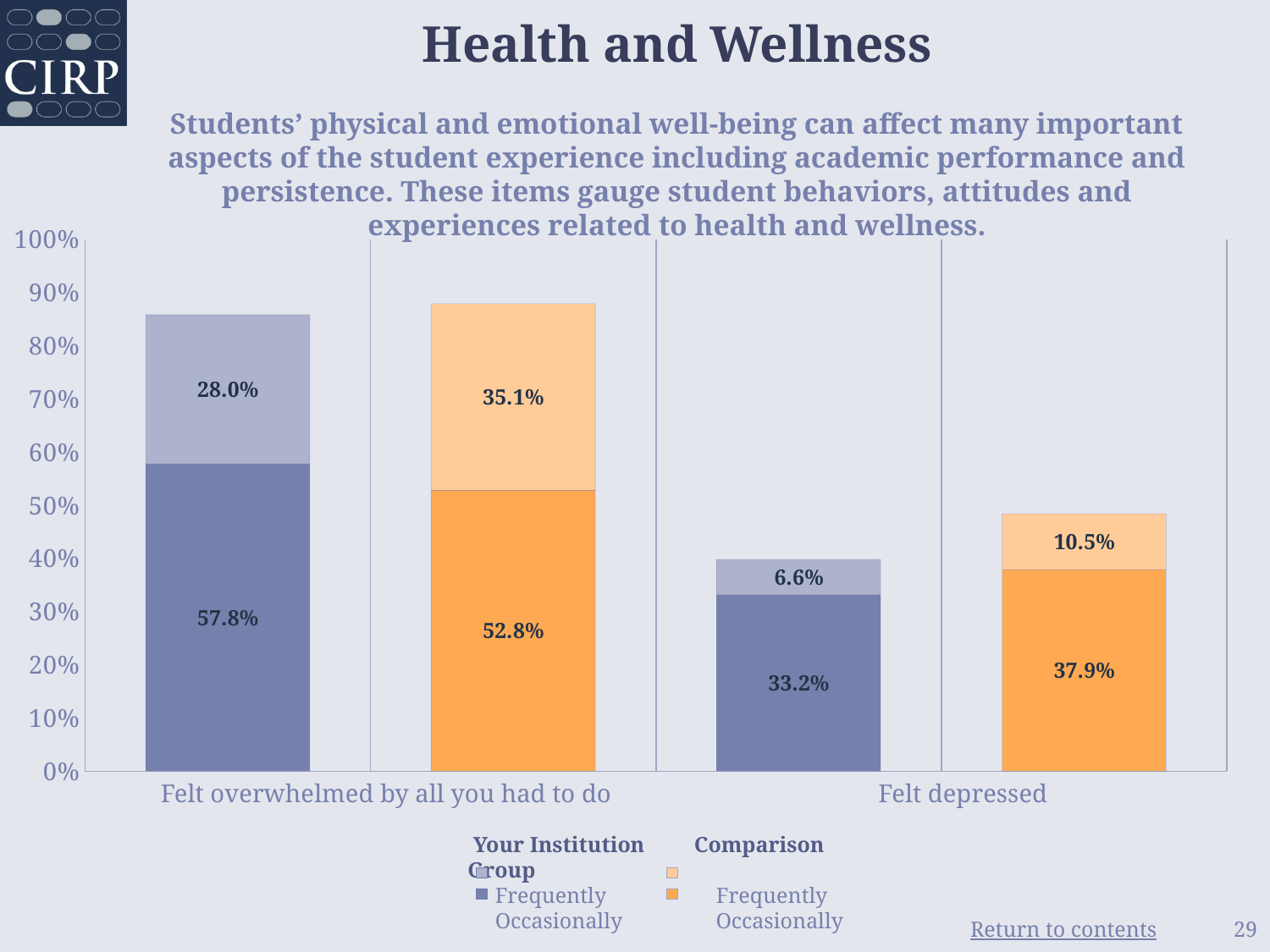
What percentage of students at Your Institution reported frequently feeling overwhelmed by all they had to do? 28.0% What percentage of the Comparison Group reported frequently feeling overwhelmed by all they had to do? 35.1% What percentage of students at Your Institution reported occasionally feeling depressed? 33.2% What is the title of the slide containing the chart? Health and Wellness How many survey items (categories) are shown on the x axis of the chart? 2 What percentage of the Comparison Group reported occasionally feeling depressed? 37.9% What type of chart is shown on the slide? Stacked bar chart What is the combined percentage (frequently plus occasionally) of the Comparison Group who felt depressed? 48.4% What is the difference between the Comparison Group and Your Institution in the percentage who frequently felt depressed? 3.9% What is the combined percentage (frequently plus occasionally) of Your Institution students who felt overwhelmed by all they had to do? 85.8% For 'Felt overwhelmed by all you had to do', which group has the higher percentage reporting 'Frequently': Your Institution or the Comparison Group? Comparison Group Is the total stacked bar for Your Institution under 'Felt depressed' greater or less than 50%? less